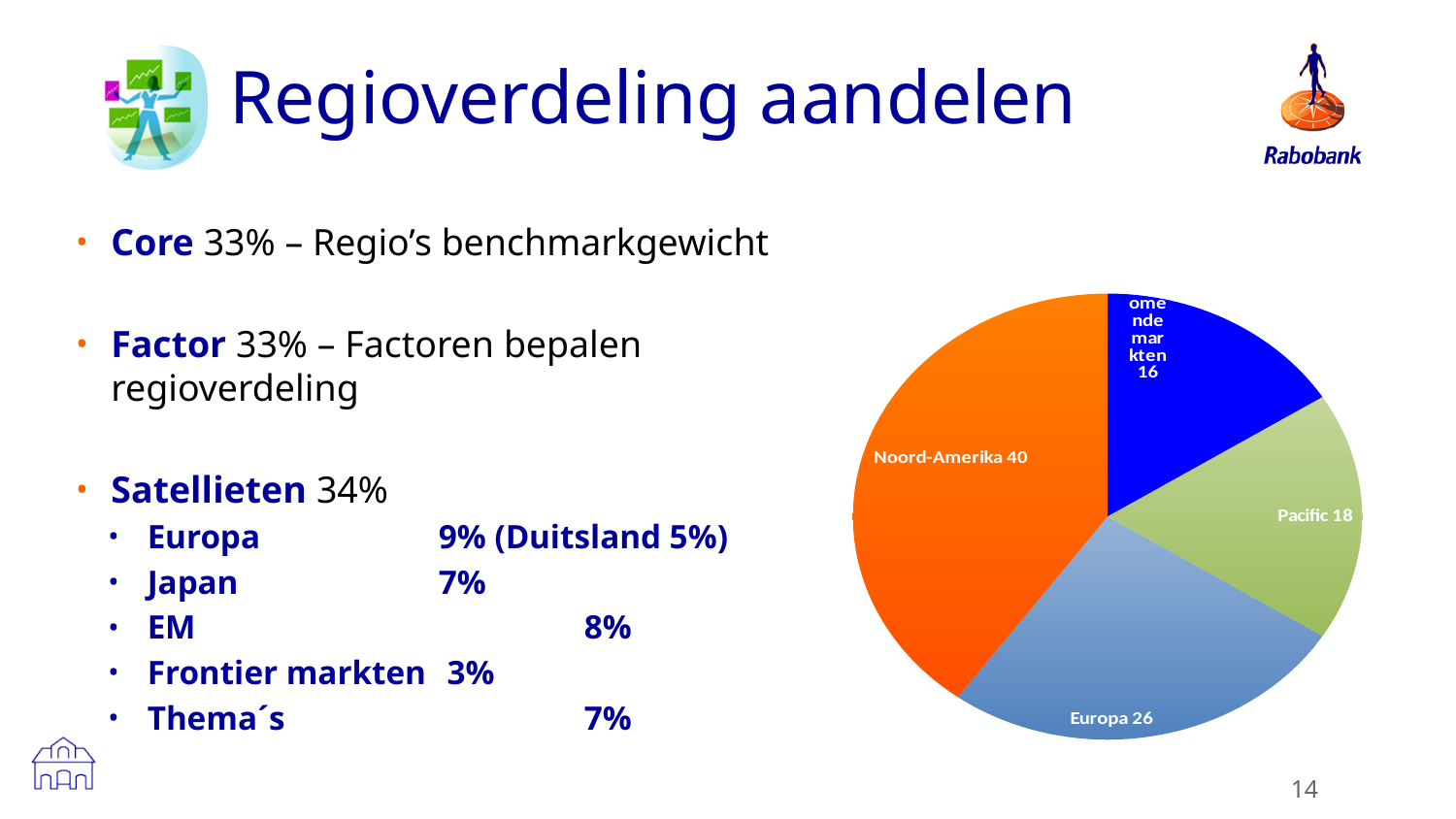
What is the value shown for Europa in the pie chart? 26 What is the difference between the values for Noord-Amerika and Europa in the pie chart? 14 What is the value shown for Noord-Amerika in the pie chart? 40 What is the title of the slide containing the pie chart? Regioverdeling aandelen Which is larger in the pie chart, Europa or Pacific? Europa Which slice of the pie chart is the largest? Noord-Amerika How many slices does the pie chart have? 4 What share of the pie does the Noord-Amerika slice represent? 40% What type of chart is shown on the slide? pie chart What is the difference between the values for Europa and Pacific in the pie chart? 8 What is the value shown for Pacific in the pie chart? 18 What colour is the Noord-Amerika slice in the pie chart? orange